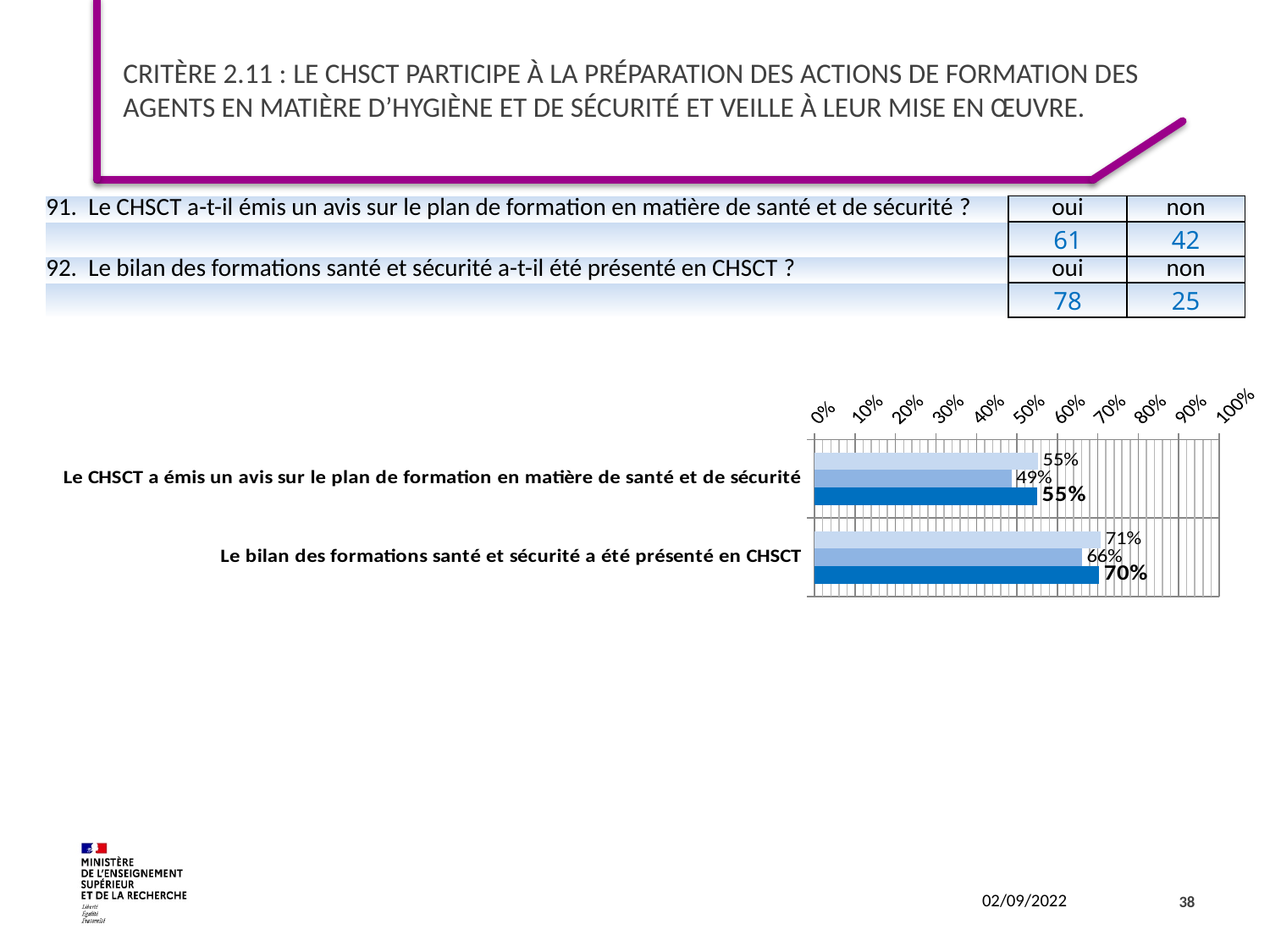
Which is larger: the middle bar for "Le bilan des formations santé et sécurité a été présenté en CHSCT" or the middle bar for "Le CHSCT a émis un avis sur le plan de formation en matière de santé et de sécurité"? Le bilan des formations santé et sécurité a été présenté en CHSCT What kind of chart is shown on the slide? bar chart What is the value of the middle bar for "Le bilan des formations santé et sécurité a été présenté en CHSCT"? 66% What is the value of the top bar for "Le bilan des formations santé et sécurité a été présenté en CHSCT"? 71% Is the middle bar value for "Le CHSCT a émis un avis sur le plan de formation en matière de santé et de sécurité" greater or less than 50%? less How many categories are plotted on the chart? 2 What is the difference between the top bar values of the two categories (71% and 55%)? 16% Which category has the highest value on the chart? Le bilan des formations santé et sécurité a été présenté en CHSCT What is the value of the bottom (bold-labelled) bar for "Le CHSCT a émis un avis sur le plan de formation en matière de santé et de sécurité"? 55% What is the value of the middle bar for "Le CHSCT a émis un avis sur le plan de formation en matière de santé et de sécurité"? 49% What is the maximum value shown on the chart's percentage axis? 100% What is the value of the bottom (bold-labelled) bar for "Le bilan des formations santé et sécurité a été présenté en CHSCT"? 70%